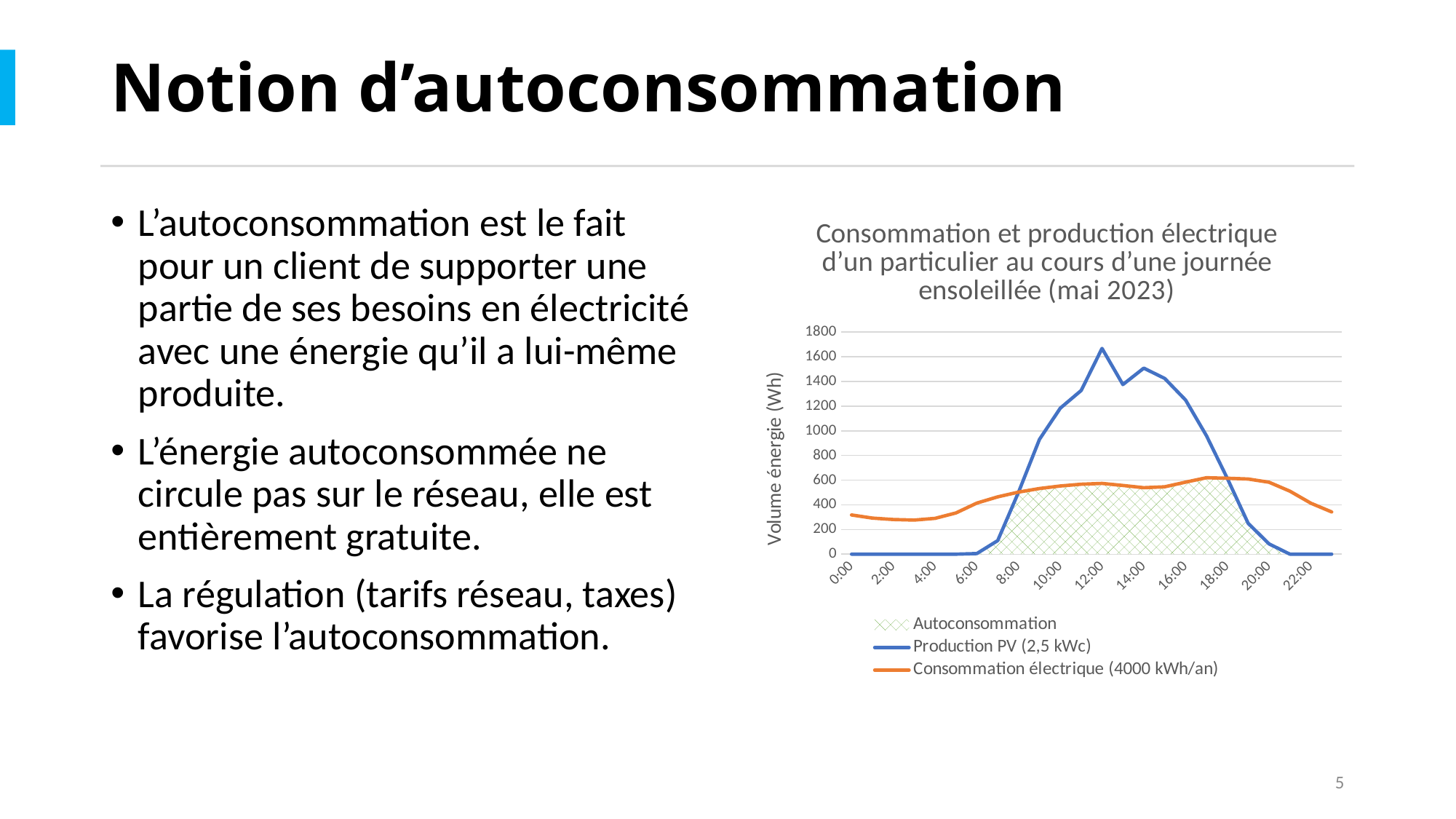
Is the value of Consommation électrique (4000 kWh/an) at 12:00 greater or less than 800? less Is the value of Consommation électrique (4000 kWh/an) at 0:00 greater or less than 400? less At 12:00, which series has the higher value: Production PV (2,5 kWc) or Consommation électrique (4000 kWh/an)? Production PV (2,5 kWc) Which series is shown as a hatched area in the chart? Autoconsommation At 4:00, which series has the higher value: Production PV (2,5 kWc) or Consommation électrique (4000 kWh/an)? Consommation électrique (4000 kWh/an) Is the value of Production PV (2,5 kWc) at 12:00 greater or less than 1400? greater What is the label of the y axis of the chart? Volume énergie (Wh) What kind of chart is shown on the slide? Combination area and line chart Does the Production PV (2,5 kWc) series rise or fall between 8:00 and 12:00? Rise How many series does the chart legend list? 3 What is the value of Production PV (2,5 kWc) at 0:00? 0 What is the value of Production PV (2,5 kWc) at 22:00? 0